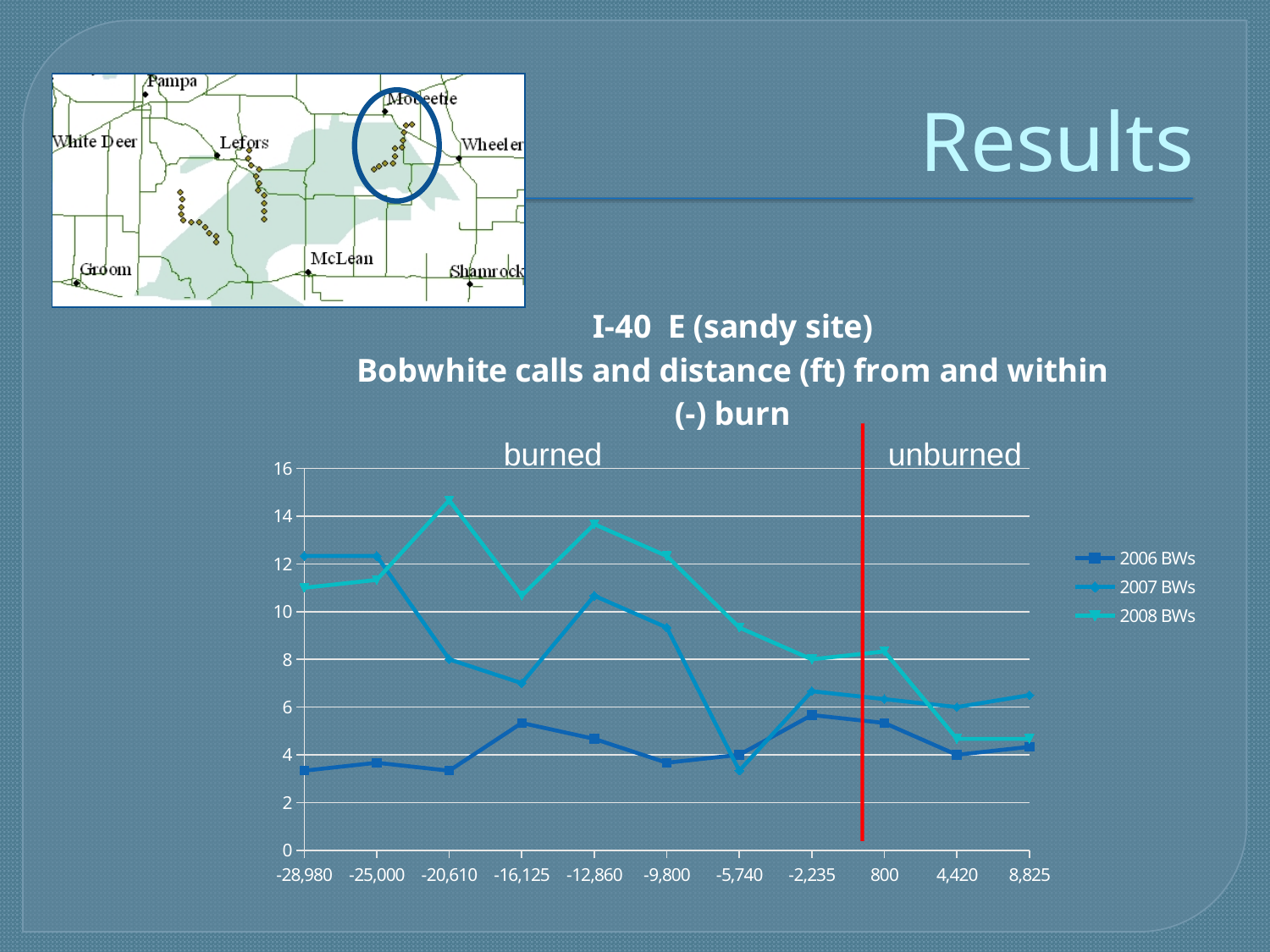
Is the value for 2008 BWs at -20,610 greater or less than 14? greater At -28,980, which series has the larger value, 2007 BWs or 2008 BWs? 2007 BWs Is the value for 2007 BWs at -12,860 greater or less than 10? greater Is the value for 2006 BWs at -28,980 greater or less than 4? less At 800, which series has the larger value, 2007 BWs or 2008 BWs? 2008 BWs At which distance does the 2007 BWs series reach its lowest value? -5,740 At which distance does the 2008 BWs series reach its highest value? -20,610 How many distance categories are shown on the x axis? 11 How many series does the legend list? 3 What kind of chart is shown on the slide? line chart Does the 2007 BWs series rise or fall from -28,980 to -16,125? fall What do the labels on either side of the red vertical line say? burned and unburned